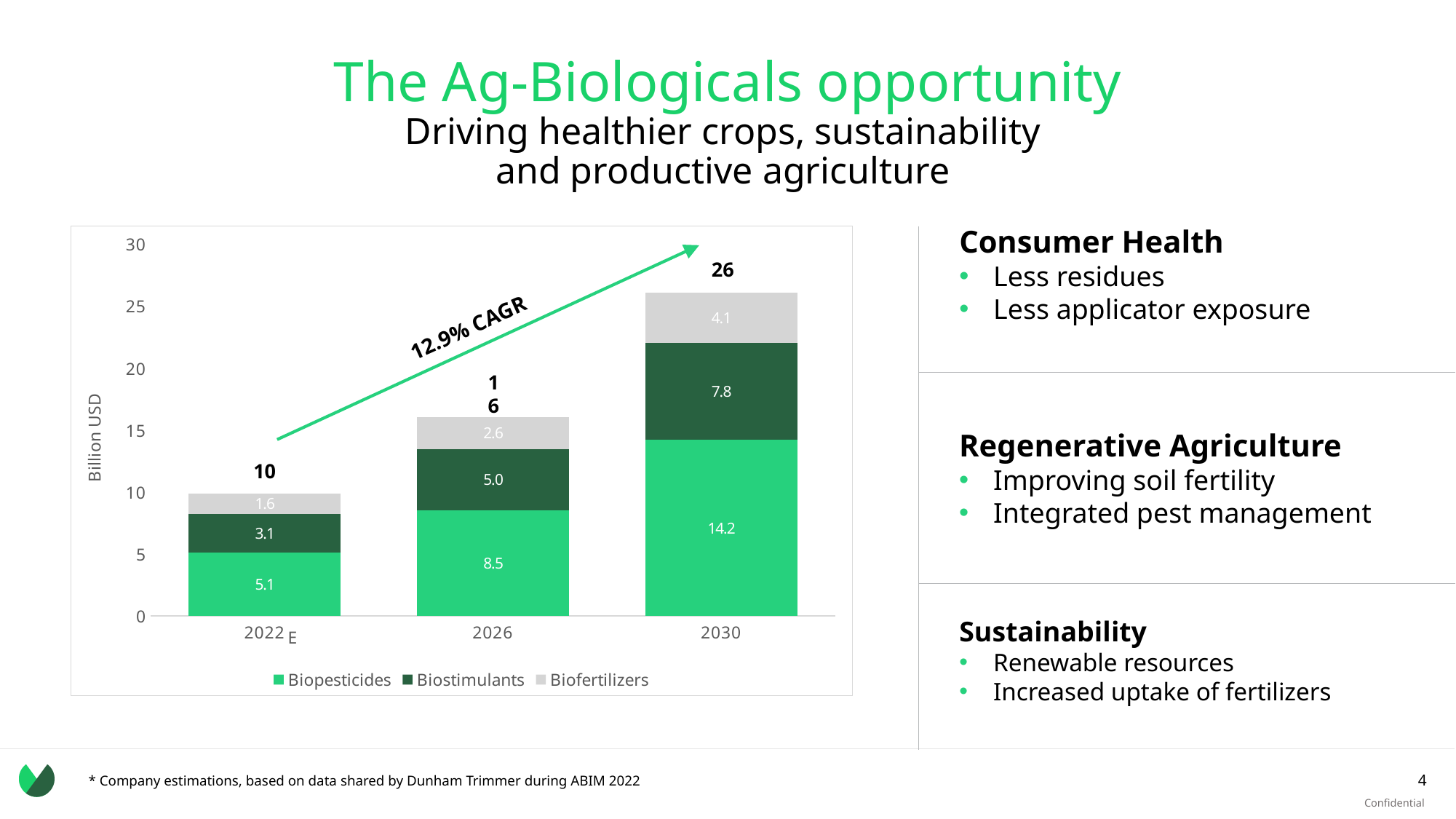
Which year has the highest Biostimulants value? 2030 What is the Biofertilizers value for 2022 E? 1.6 What is the difference between the Biopesticides values for 2030 and 2026? 5.7 What is the Biopesticides value for 2030? 14.2 What CAGR is annotated on the chart? 12.9% CAGR What is the total of the stacked bar for 2022 E? 10 What kind of chart is shown on the slide? Stacked bar chart Do the total values rise or fall from 2022 E to 2030? Rise How many years (categories) are shown on the x axis of the chart? 3 How many series does the chart legend list? 3 What is the Biostimulants value for 2026? 5.0 What is the total of the stacked bar for 2030? 26